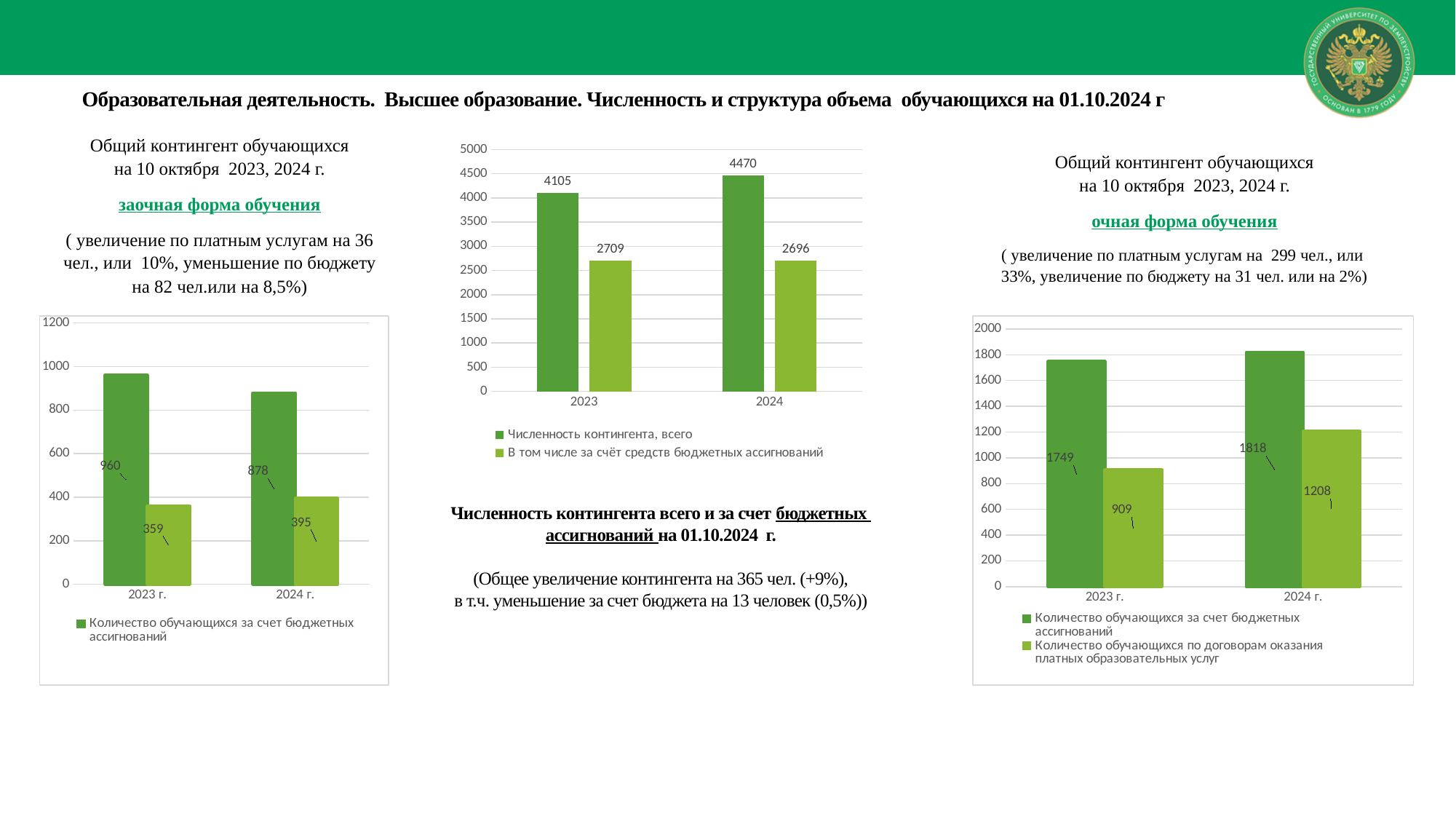
What type of chart is the middle chart? bar chart In the left chart (заочная форма обучения), what is the value of the dark green bar for 2023 г.? 960 In the right chart (очная форма обучения), what is the value of 'Количество обучающихся за счет бюджетных ассигнований' for 2023 г.? 1749 In the middle chart, what is the value of 'Численность контингента, всего' for 2024? 4470 In the left chart (заочная форма обучения), what is the value of the light green bar for 2024 г.? 395 In the left chart (заочная форма обучения), does the dark green bar rise or fall from 2023 г. to 2024 г.? fall In the right chart (очная форма обучения), which year has the higher value for paid educational services? 2024 г. In the right chart (очная форма обучения), what is the difference between the paid-services values for 2024 г. and 2023 г.? 299 In the middle chart, how many series does the legend list? 2 In the right chart (очная форма обучения), what is the value of 'Количество обучающихся по договорам оказания платных образовательных услуг' for 2024 г.? 1208 In the middle chart, what is the difference between the total contingent in 2024 and in 2023? 365 In the middle chart, what is the value of 'В том числе за счёт средств бюджетных ассигнований' for 2023? 2709